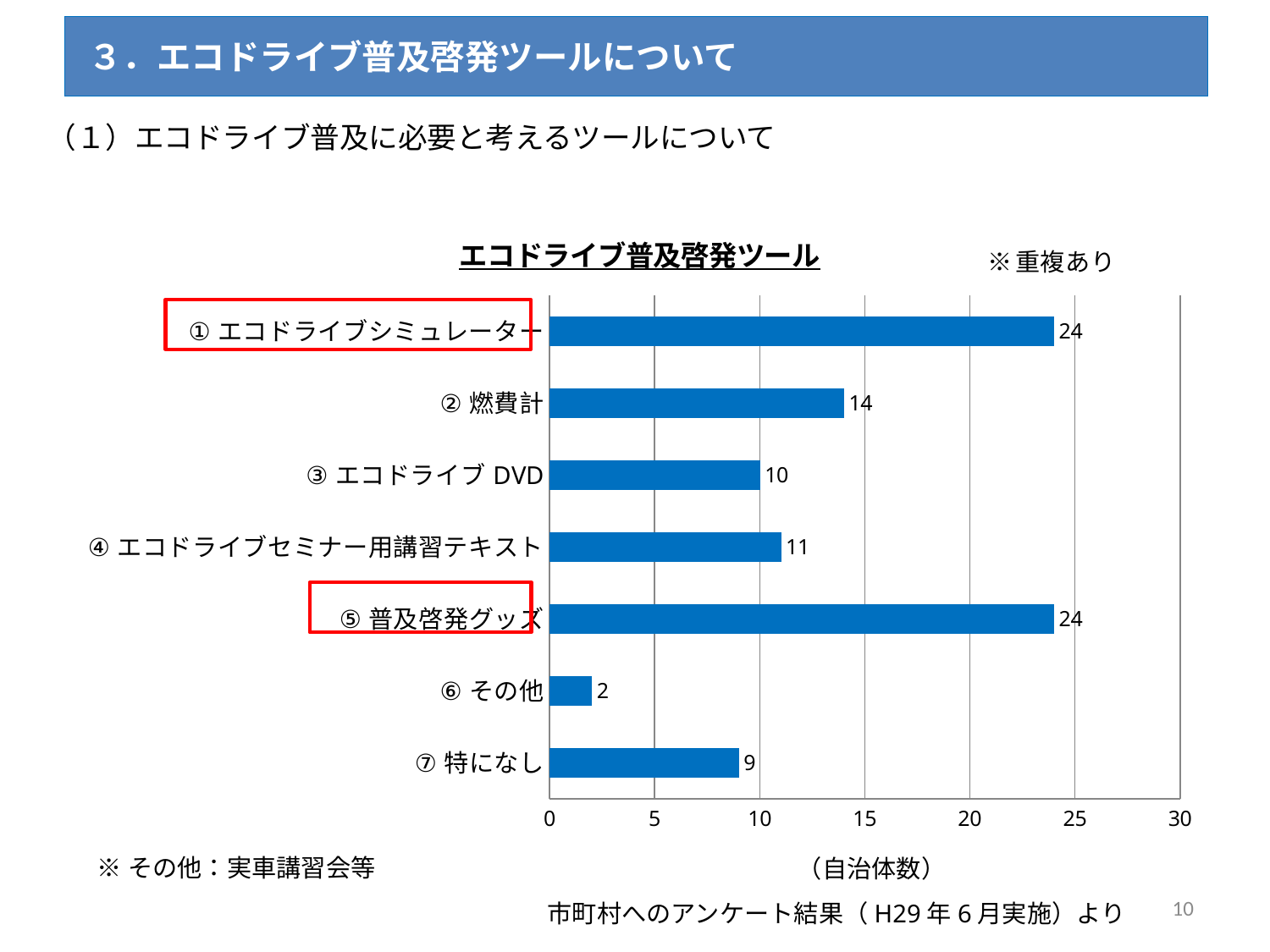
What kind of chart is shown on the slide? bar chart What is the value for ③ エコドライブ DVD? 10 Which is larger, the value for ③ エコドライブ DVD or ④ エコドライブセミナー用講習テキスト? ④ エコドライブセミナー用講習テキスト What is the difference between the values for ① エコドライブシミュレーター and ② 燃費計? 10 Which category has the lowest value? ⑥ その他 How many categories are shown in the chart? 7 Is the value for ⑤ 普及啓発グッズ greater or less than 20? greater What is the value for ② 燃費計? 14 What is the title of the chart? エコドライブ普及啓発ツール What is the value for ④ エコドライブセミナー用講習テキスト? 11 What is the highest value shown in the chart? 24 What is the value for ⑦ 特になし? 9